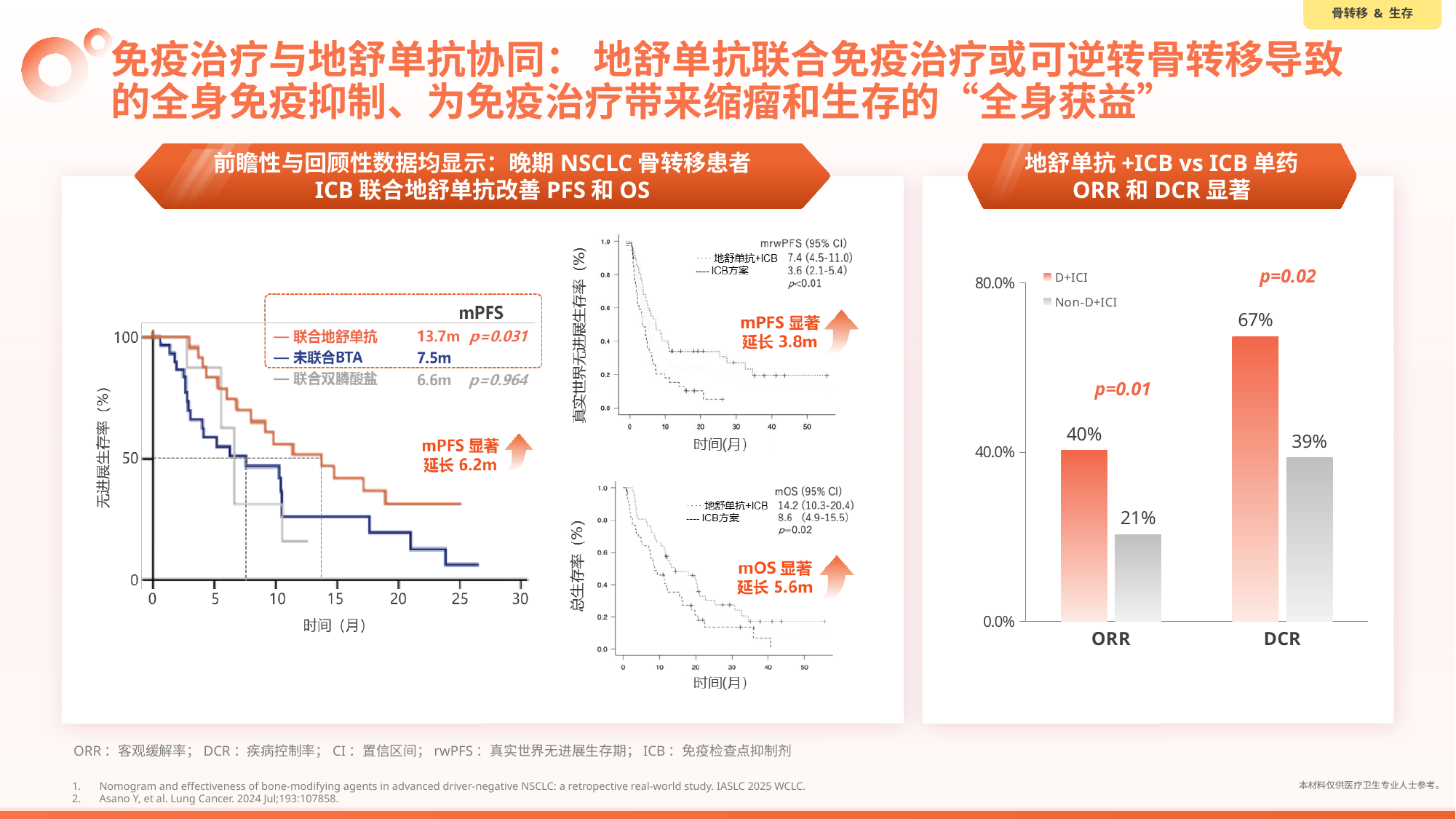
In the large survival curve chart on the left, what is the mPFS for the 未联合BTA group? 7.5m In the bar chart on the right (ORR and DCR), which bar is the tallest? DCR for D+ICI (67%) In the bar chart on the right (ORR and DCR), what is the difference between the DCR values for D+ICI and Non-D+ICI? 28% In the middle-top survival curve chart (mrwPFS), what is the mrwPFS for the ICB方案 group? 3.6 (2.1-5.4) In the bar chart on the right (ORR and DCR), what is the DCR value for Non-D+ICI? 39% In the middle-bottom survival curve chart (mOS), what is the mOS for the 地舒单抗+ICB group? 14.2 (10.3-20.4) In the large survival curve chart on the left, what is the mPFS for the 联合地舒单抗 group? 13.7m In the bar chart on the right (ORR and DCR), how many series does the legend list? 2 In the bar chart on the right (ORR and DCR), what is the ORR value for D+ICI? 40% In the bar chart on the right (ORR and DCR), which series has the higher ORR, D+ICI or Non-D+ICI? D+ICI What kind of chart is the chart on the right showing ORR and DCR? Bar chart In the bar chart on the right (ORR and DCR), what p-value is shown above the DCR bars? p=0.02